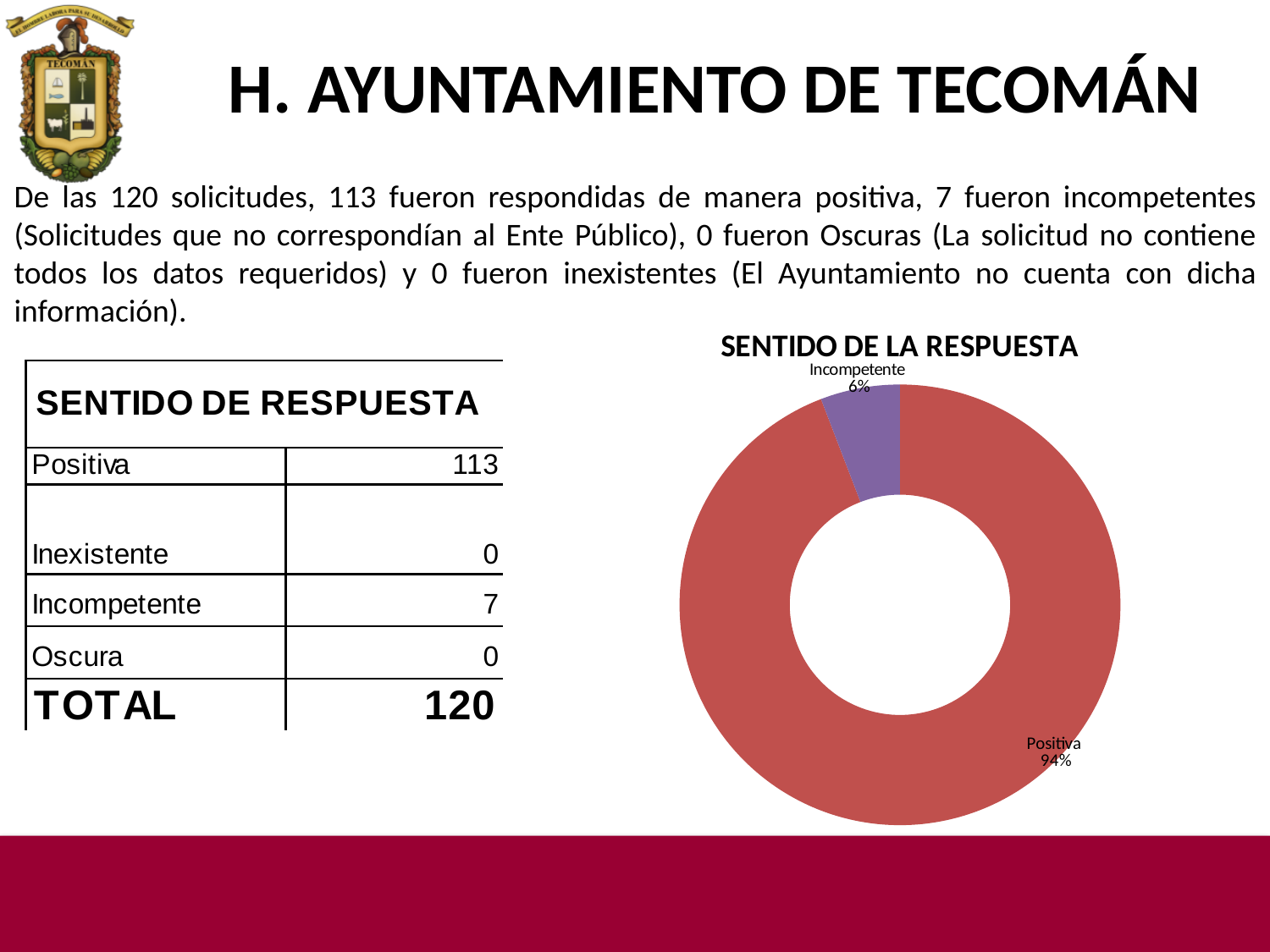
What is the title of the chart on the slide? SENTIDO DE LA RESPUESTA How many labelled slices are shown in the chart? 2 What colour is the Positiva slice in the chart? Red Which slice is larger in the chart, Positiva or Incompetente? Positiva What percentage share does the Positiva slice have in the chart? 94% What is the difference in percentage points between the Positiva and Incompetente slices? 88 percentage points Which slice is the largest in the chart? Positiva Which labelled slice is the smallest in the chart? Incompetente What percentage share does the Incompetente slice have in the chart? 6% What kind of chart is shown on the slide? Doughnut chart